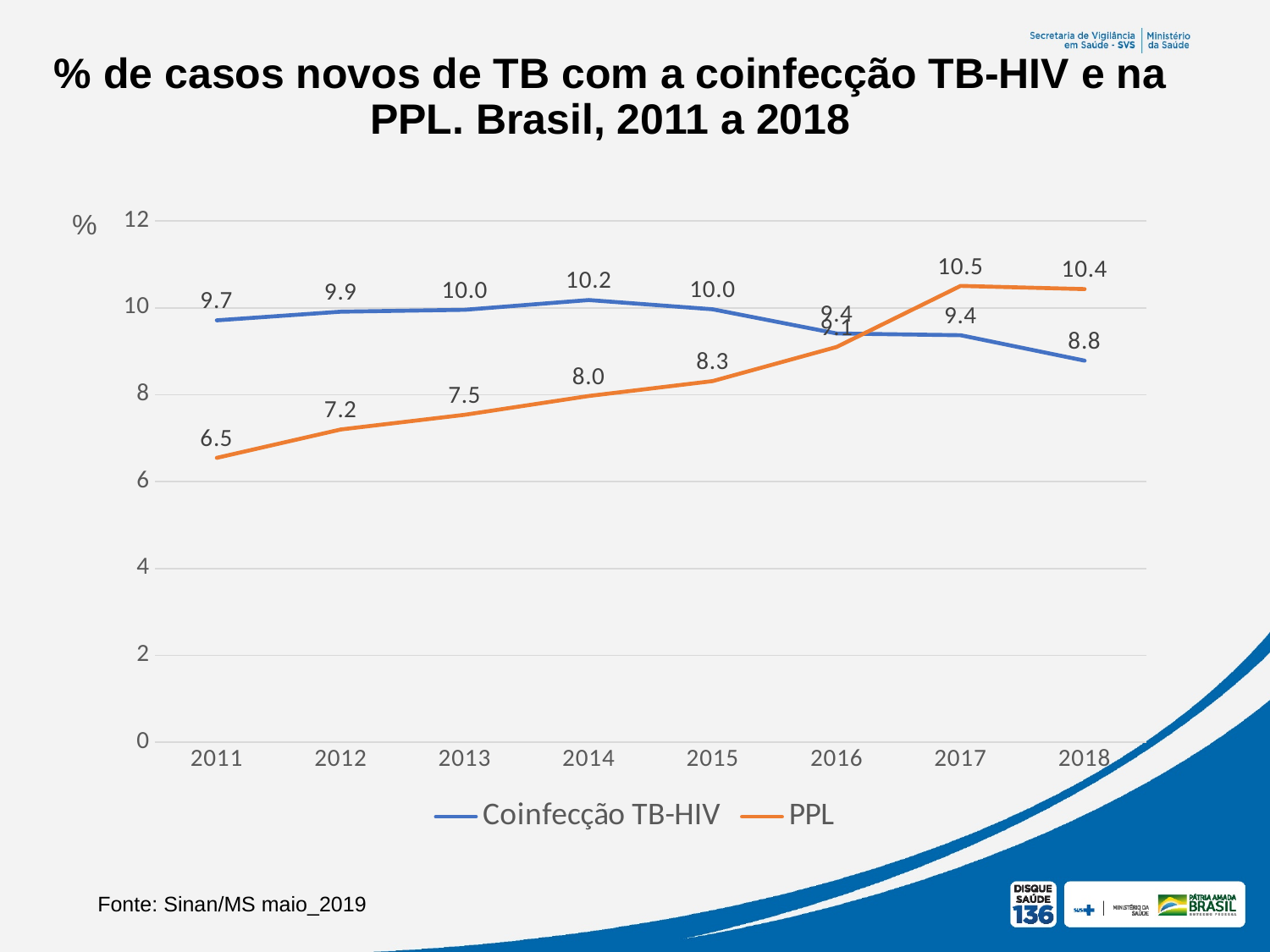
In 2013, which series has the larger value, Coinfecção TB-HIV or PPL? Coinfecção TB-HIV In which year is the PPL series at its highest? 2017 What is the value for PPL in 2017? 10.5 In which year does the Coinfecção TB-HIV series reach its highest value? 2014 How many years are shown on the x axis? 8 What is the value for Coinfecção TB-HIV in 2011? 9.7 In which year is the PPL series at its lowest? 2011 What is the difference between the PPL value and the Coinfecção TB-HIV value in 2018? 1.6 Is the value for PPL in 2012 greater or less than 8? less What is the value for Coinfecção TB-HIV in 2018? 8.8 How many series does the legend list? 2 What kind of chart is shown on the slide? line chart